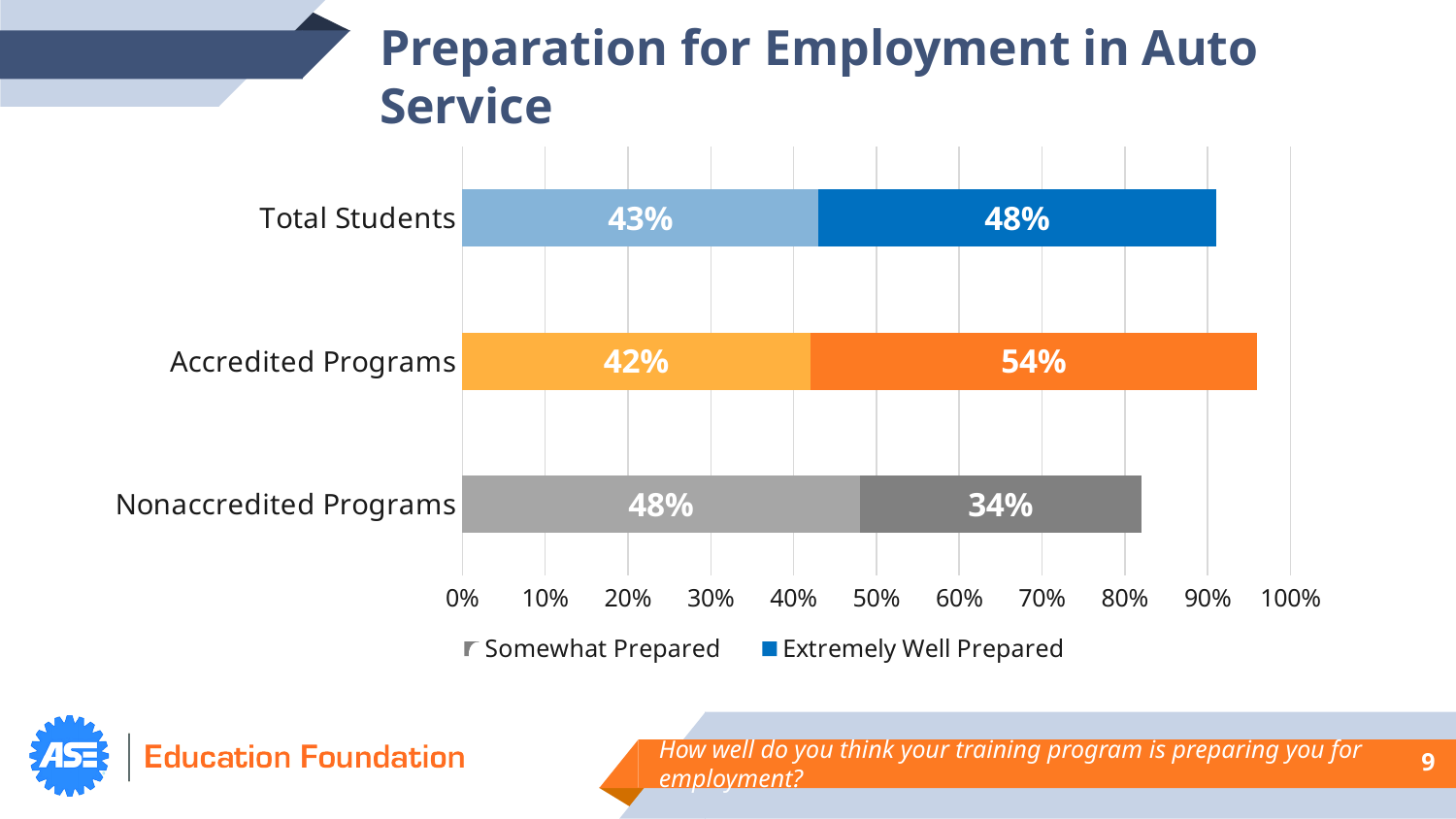
What is the total of the stacked bar for Total Students? 91% How many series does the legend list? 2 What percentage of students in Accredited Programs are Somewhat Prepared? 42% Which is larger for Nonaccredited Programs: Somewhat Prepared or Extremely Well Prepared? Somewhat Prepared What percentage of students in Nonaccredited Programs are Extremely Well Prepared? 34% What is the difference between the Extremely Well Prepared percentages for Accredited Programs and Nonaccredited Programs? 20% What kind of chart is shown on the slide? Stacked bar chart What is the total of the stacked bar for Accredited Programs? 96% Which category has the highest Extremely Well Prepared percentage? Accredited Programs Which category has the lowest Extremely Well Prepared percentage? Nonaccredited Programs How many categories are shown on the chart? 3 What percentage of Total Students are Extremely Well Prepared? 48%